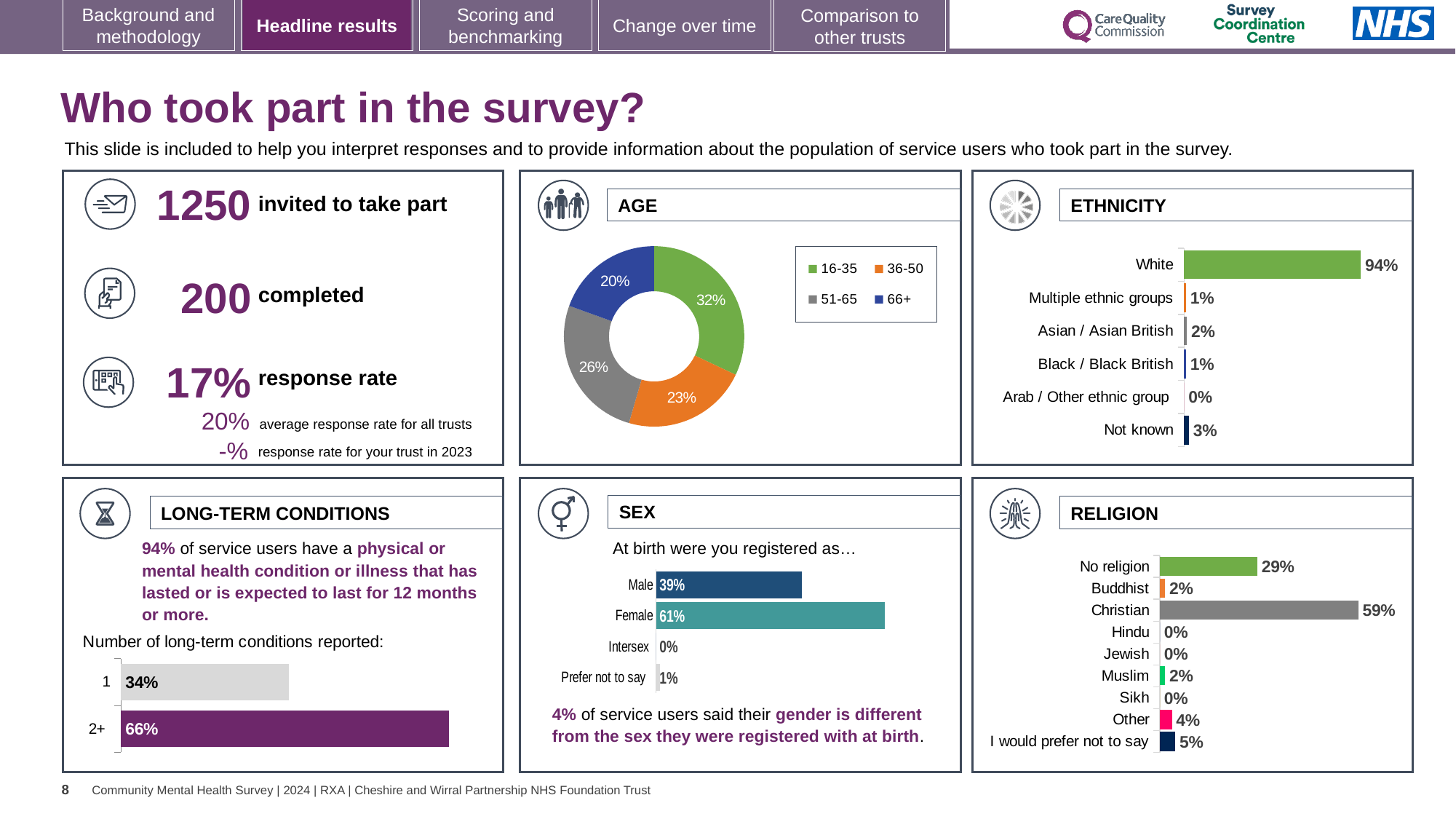
In the AGE chart, what share of respondents were aged 16-35? 32% In the SEX chart, which is larger, Male or Female? Female How many age groups does the legend of the AGE chart list? 4 In the SEX chart, what is the difference between the Female and Male values? 22% In the RELIGION chart, which category has the highest value? Christian How many ethnicity categories are shown in the ETHNICITY chart? 6 In the RELIGION chart, what is the value for I would prefer not to say? 5% In the LONG-TERM CONDITIONS chart, what percentage reported 2+ conditions? 66% In the ETHNICITY chart, what is the value for White? 94% What kind of chart is the AGE chart? Doughnut chart In the ETHNICITY chart, what is the value for Not known? 3% In the AGE chart, which age group has the smallest share? 66+